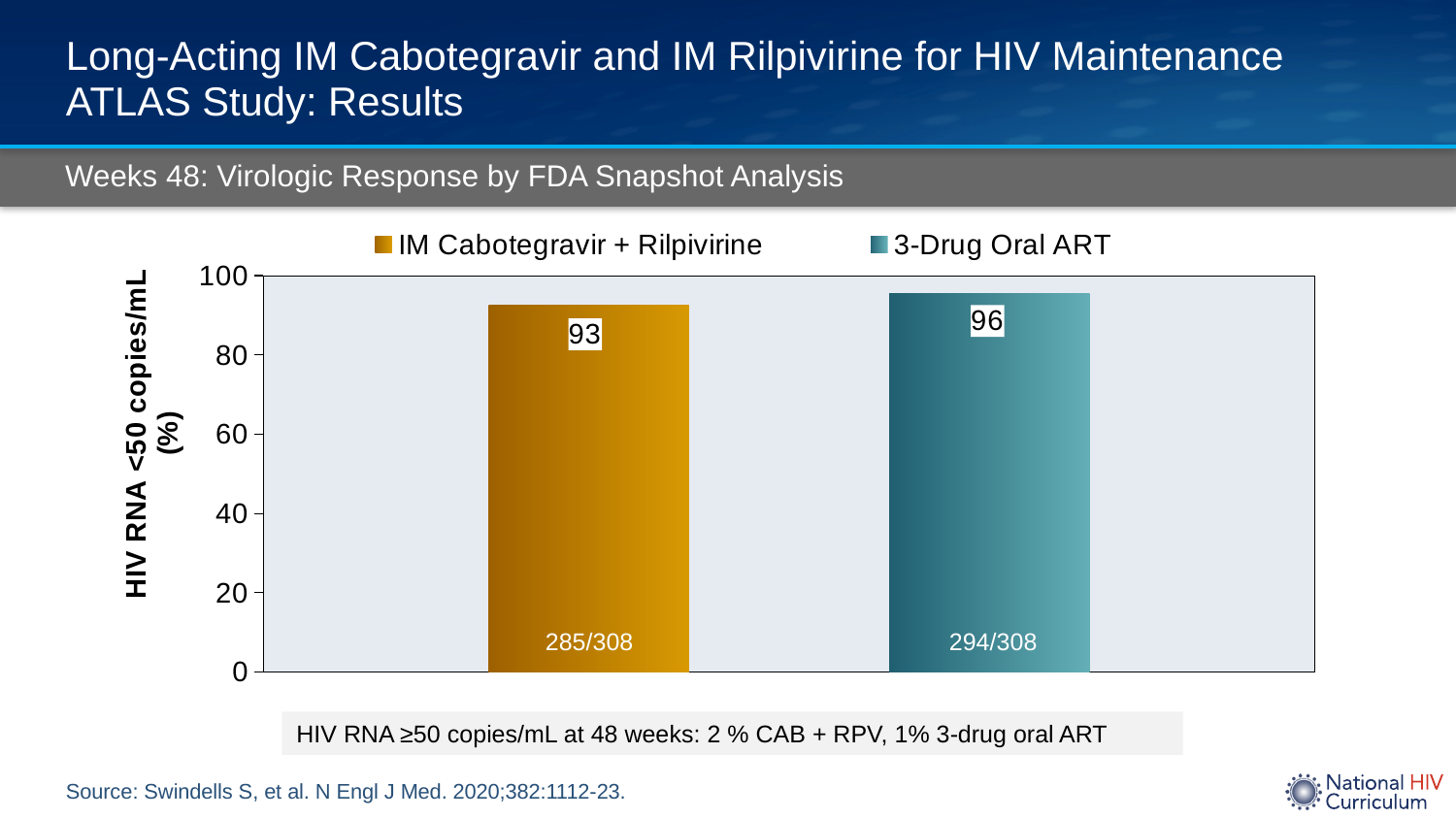
What kind of chart is shown on the slide? Bar chart What fraction is printed on the 3-Drug Oral ART bar? 294/308 What fraction is printed on the IM Cabotegravir + Rilpivirine bar? 285/308 Which series has the higher value, IM Cabotegravir + Rilpivirine or 3-Drug Oral ART? 3-Drug Oral ART Is the value for IM Cabotegravir + Rilpivirine greater or less than 80? greater How many bars are plotted in the chart? 2 What is the difference between the values for 3-Drug Oral ART and IM Cabotegravir + Rilpivirine? 3 What is the value for 3-Drug Oral ART? 96 What is the value for IM Cabotegravir + Rilpivirine? 93 What is the label of the y axis? HIV RNA <50 copies/mL (%) Which series has the lowest value? IM Cabotegravir + Rilpivirine How many series does the legend list? 2